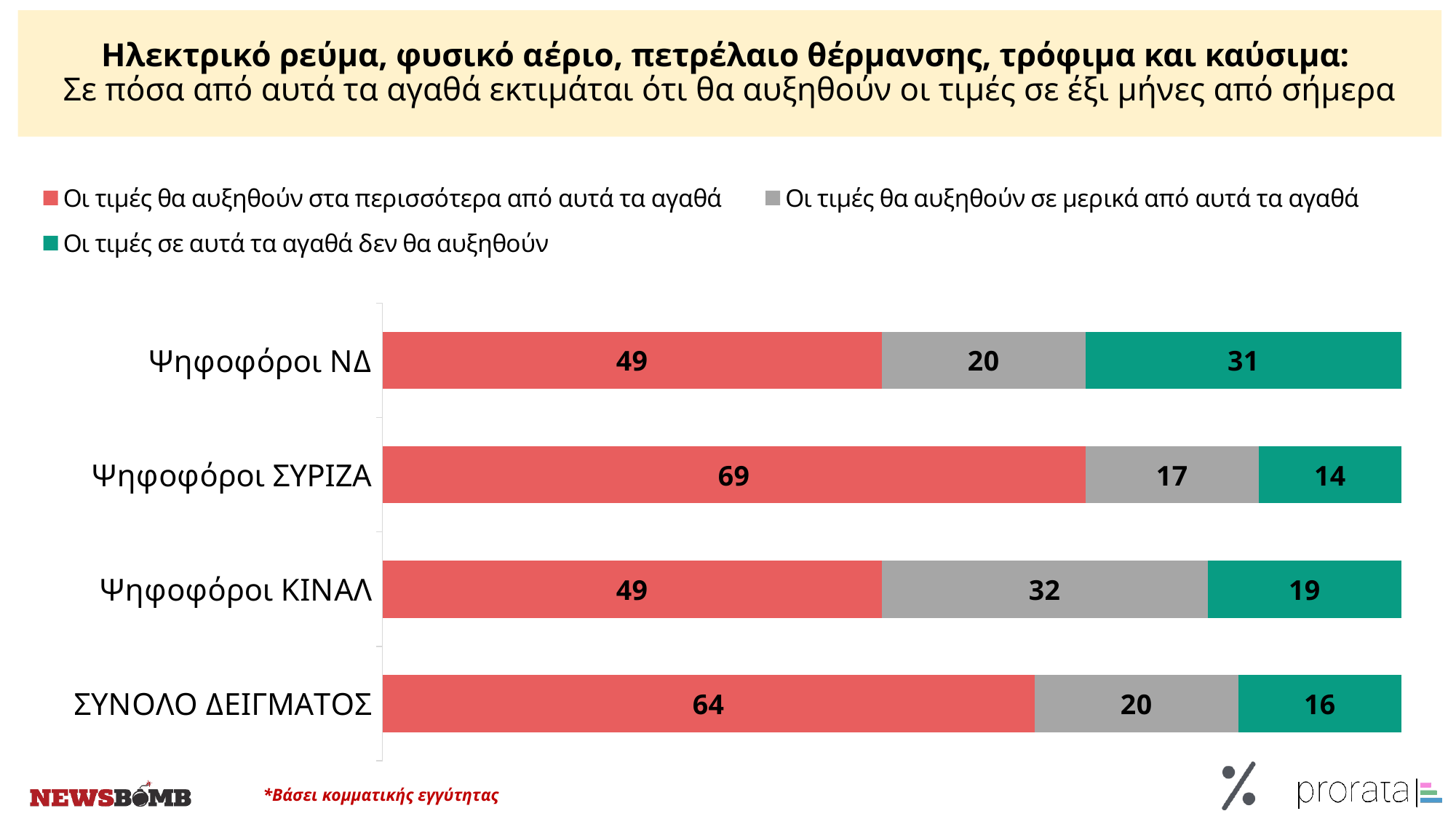
How many series does the legend list? 3 What is the difference between the 'Οι τιμές θα αυξηθούν στα περισσότερα από αυτά τα αγαθά' values for Ψηφοφόροι ΣΥΡΙΖΑ and Ψηφοφόροι ΝΔ? 20 Which category has the lowest value for 'Οι τιμές σε αυτά τα αγαθά δεν θα αυξηθούν'? Ψηφοφόροι ΣΥΡΙΖΑ How many categories (voter groups) are shown on the chart? 4 What is the value for 'Οι τιμές σε αυτά τα αγαθά δεν θα αυξηθούν' for Ψηφοφόροι ΝΔ? 31 What kind of chart is shown on the slide? Stacked bar chart What is the value for 'Οι τιμές θα αυξηθούν στα περισσότερα από αυτά τα αγαθά' for Ψηφοφόροι ΣΥΡΙΖΑ? 69 What is the total of the stacked bar for Ψηφοφόροι ΚΙΝΑΛ? 100 What is the value for 'Οι τιμές θα αυξηθούν σε μερικά από αυτά τα αγαθά' for Ψηφοφόροι ΚΙΝΑΛ? 32 Which category has the highest value for 'Οι τιμές θα αυξηθούν στα περισσότερα από αυτά τα αγαθά'? Ψηφοφόροι ΣΥΡΙΖΑ What is the value for 'Οι τιμές θα αυξηθούν στα περισσότερα από αυτά τα αγαθά' for ΣΥΝΟΛΟ ΔΕΙΓΜΑΤΟΣ? 64 Which is larger: the 'Οι τιμές σε αυτά τα αγαθά δεν θα αυξηθούν' value for Ψηφοφόροι ΝΔ or for Ψηφοφόροι ΚΙΝΑΛ? Ψηφοφόροι ΝΔ